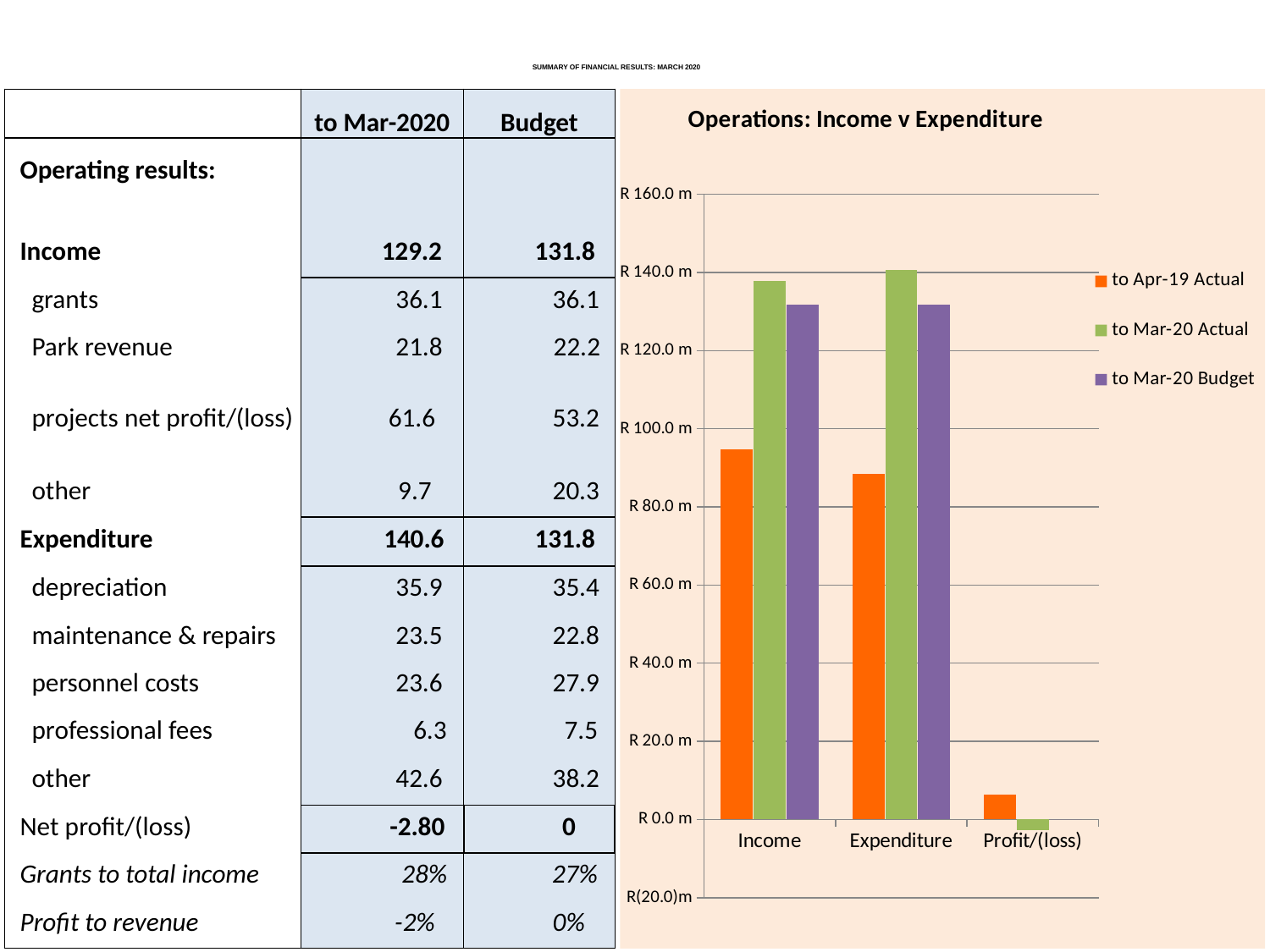
For Expenditure, which series has the larger value: to Apr-19 Actual or to Mar-20 Actual? to Mar-20 Actual What kind of chart is shown on the slide? bar chart Which category has the lowest value in the to Mar-20 Actual series? Profit/(loss) Is the value for Expenditure in the to Apr-19 Actual series greater or less than R 80.0 m? greater Which category has the highest value in the to Mar-20 Actual series? Expenditure Is the value for Profit/(loss) in the to Apr-19 Actual series greater or less than R 0.0 m? greater Is the value for Expenditure in the to Mar-20 Actual series greater or less than R 120.0 m? greater How many categories are shown on the x axis of the chart? 3 For Income, which series has the larger value: to Mar-20 Actual or to Mar-20 Budget? to Mar-20 Actual How many series does the chart legend list? 3 What is the title of the chart? Operations: Income v Expenditure